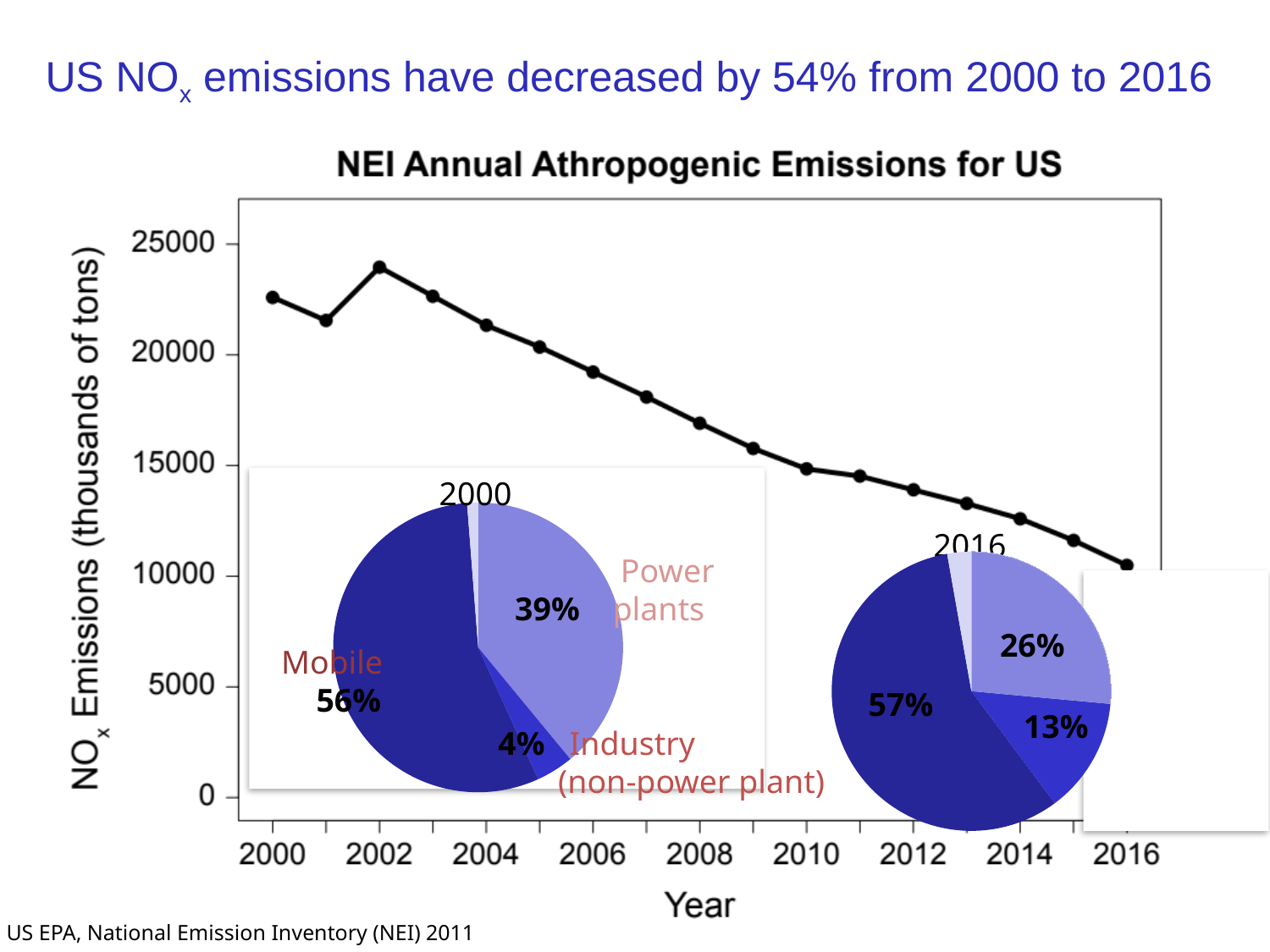
In the line chart 'NEI Annual Athropogenic Emissions for US', do NOx emissions generally rise or fall from 2002 to 2016? fall In the 2000 pie chart, what share of NOx emissions comes from Power plants? 39% In the line chart 'NEI Annual Athropogenic Emissions for US', how many yearly data points are plotted? 17 In the line chart 'NEI Annual Athropogenic Emissions for US', which year has the lowest NOx emissions? 2016 In the line chart 'NEI Annual Athropogenic Emissions for US', is the value for 2000 greater or less than 20000? greater In the line chart 'NEI Annual Athropogenic Emissions for US', is the value for 2014 greater or less than 15000? less In the line chart 'NEI Annual Athropogenic Emissions for US', which year has the highest NOx emissions? 2002 What is the y-axis label of the line chart 'NEI Annual Athropogenic Emissions for US'? NOx Emissions (thousands of tons) In the line chart 'NEI Annual Athropogenic Emissions for US', is the value for 2002 greater or less than 25000? less What kind of chart is the large chart titled 'NEI Annual Athropogenic Emissions for US'? line chart In the 2000 pie chart, what share of NOx emissions comes from Mobile sources? 56% In the 2000 pie chart, what share of NOx emissions comes from Industry (non-power plant)? 4%